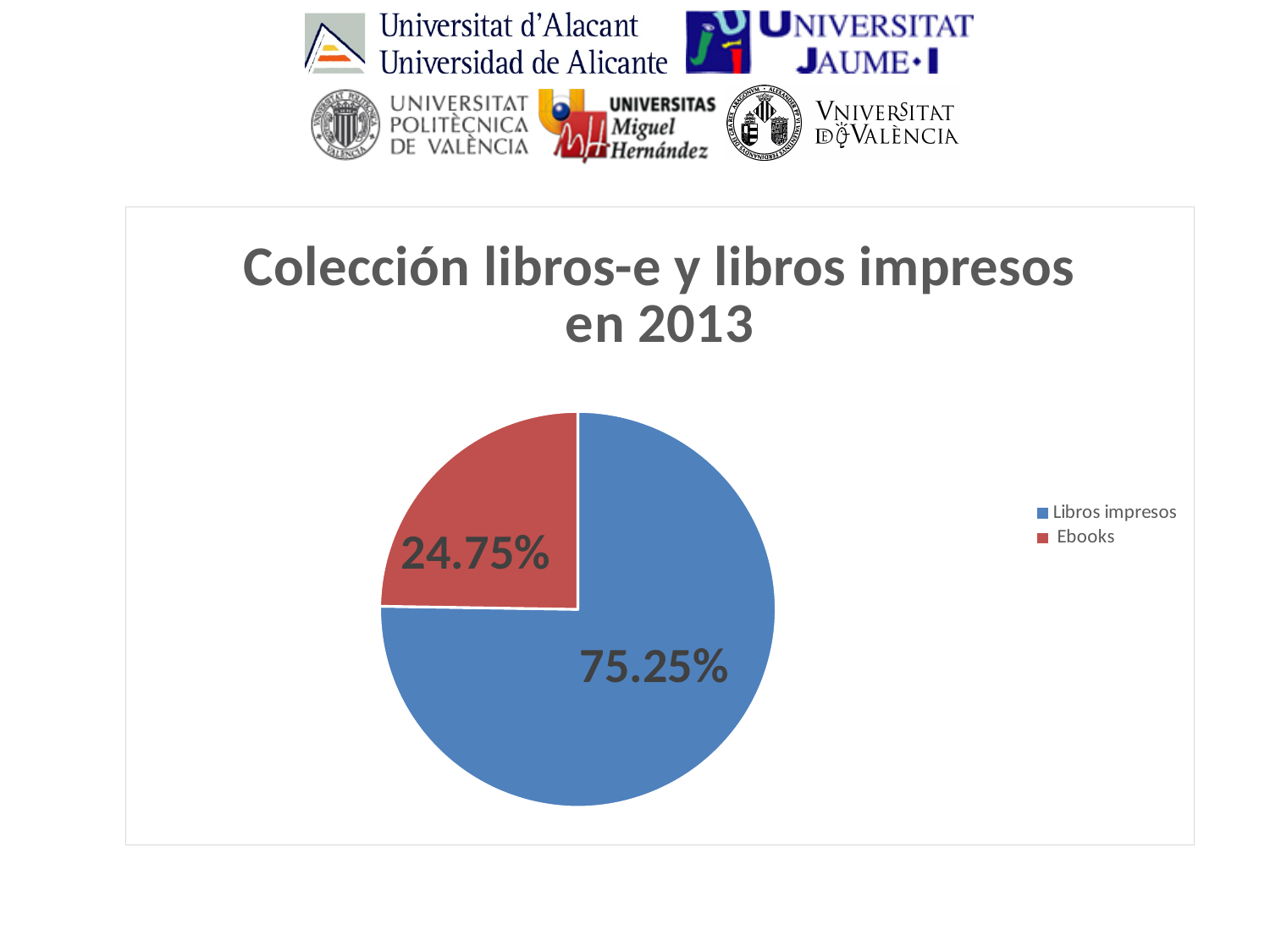
How many categories are shown in the pie chart? 2 Which category has the smallest slice of the pie? Ebooks What colour is the Ebooks slice in the pie chart? Red What is the difference in percentage points between Libros impresos and Ebooks? 50.5 What share of the pie does Ebooks represent? 24.75% What is the title of the chart? Colección libros-e y libros impresos en 2013 What kind of chart is shown on the slide? Pie chart Is the share for Ebooks greater or less than 50%? less What share of the pie does Libros impresos represent? 75.25% Which is larger, the share for Libros impresos or the share for Ebooks? Libros impresos Which category has the largest slice of the pie? Libros impresos